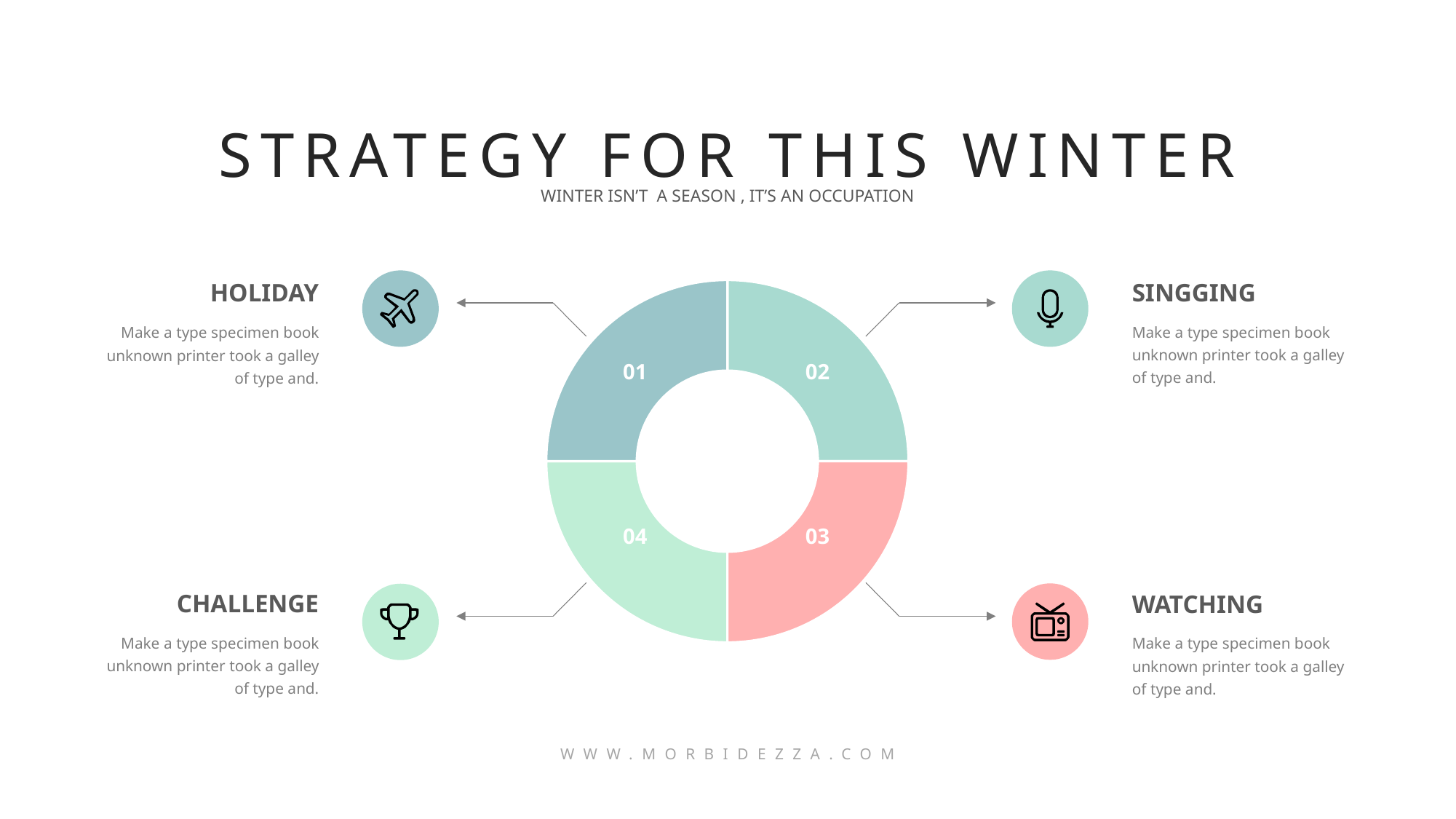
What kind of chart is shown in the centre of the slide? Pie chart (donut) Which number is printed on the top-left segment of the donut chart? 01 Which number is printed on the bottom-left segment of the donut chart? 04 Which number is printed on the top-right segment of the donut chart? 02 Which number is printed on the bottom-right segment of the donut chart? 03 What colour is segment 03 of the donut chart? Pink Which labelled item is connected to segment 01 of the donut chart? HOLIDAY How many segments does the donut chart have? 4